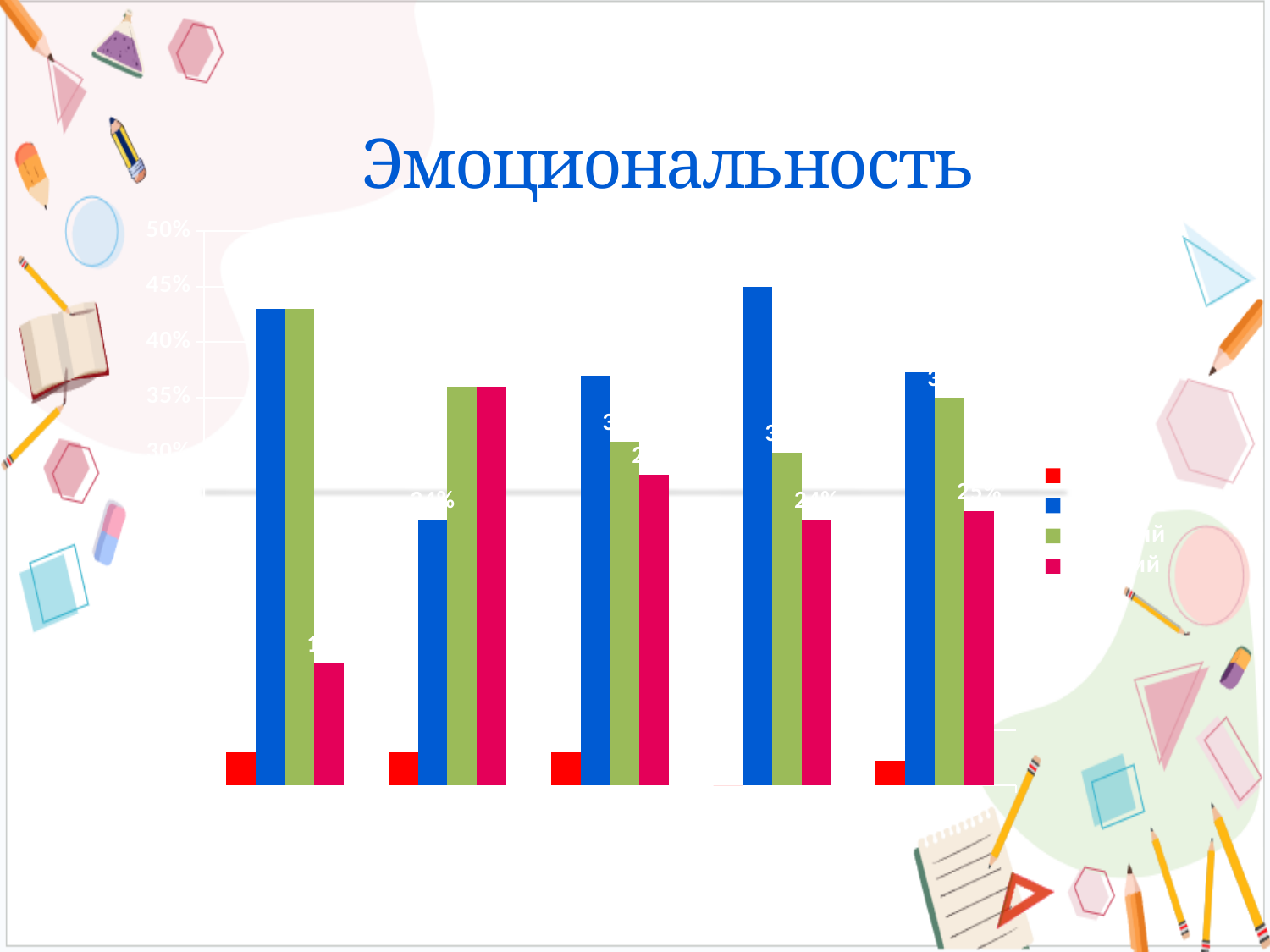
How many series does the legend list? 4 Is the value of the blue bar in the fourth group from the left greater or less than 40%? greater Is the value of the blue bar in the first group from the left greater or less than 40%? greater In the fourth group from the left, which coloured bar is the tallest? blue Which coloured series has the shortest bar in every group? red How many groups of bars are plotted along the x axis? 5 What colours are the four series in the legend, from top to bottom? red, blue, green, pink What is the title of the chart? Эмоциональность In the first group from the left, is the blue bar or the pink bar taller? blue What kind of chart is shown on the slide? bar chart